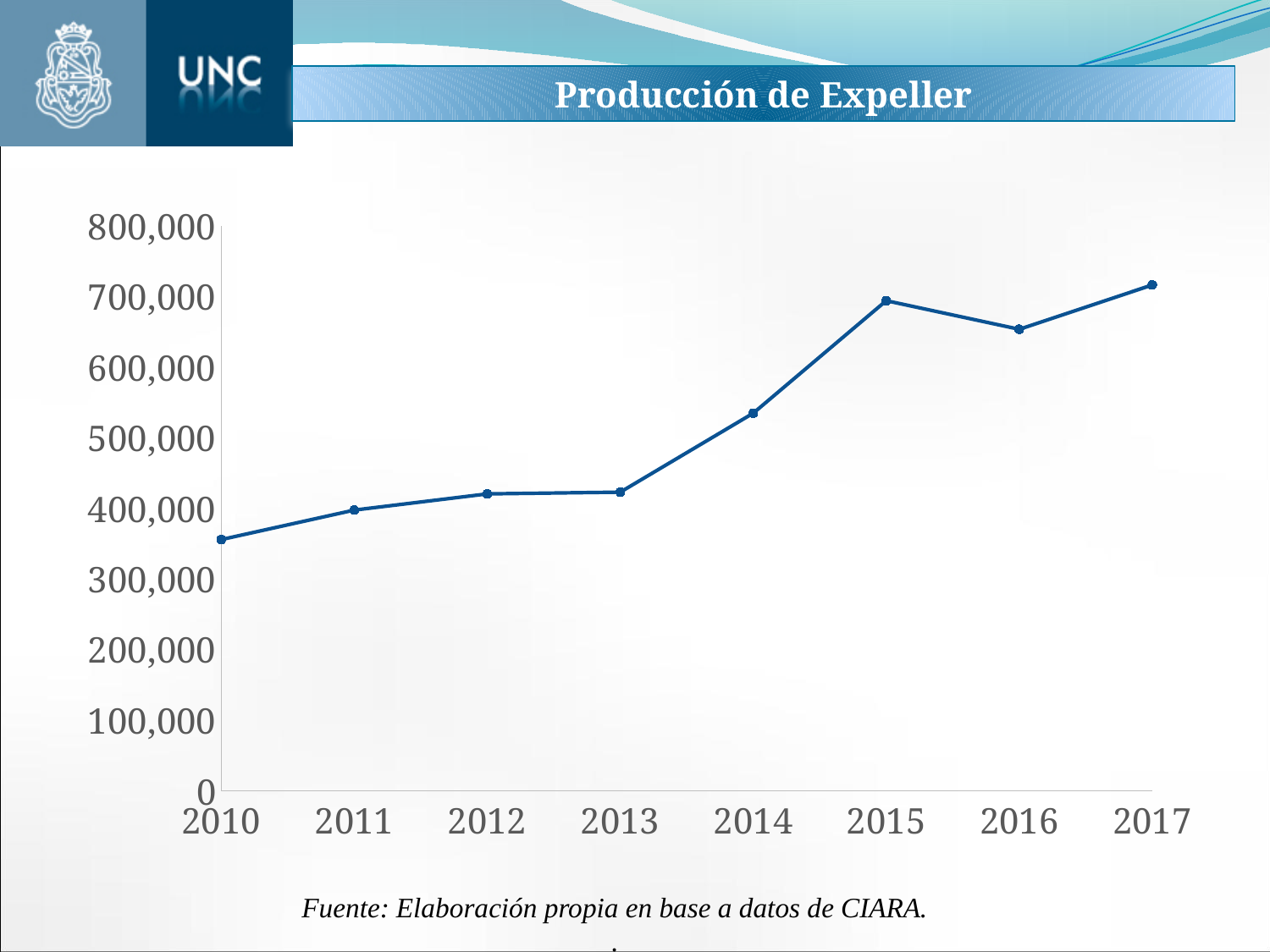
Which year has the lowest value? 2010 Does the value rise or fall from 2013 to 2015? rise Is the value for 2017 greater or less than 700,000? greater Is the value for 2014 greater or less than 500,000? greater Which year has the highest value? 2017 Is the value for 2010 greater or less than 400,000? less What is the title of the chart? Producción de Expeller According to the note below the chart, what is the data source? Elaboración propia en base a datos de CIARA How many years are plotted on the x axis? 8 Which is larger, the value for 2015 or the value for 2016? 2015 What kind of chart is shown on the slide? line chart